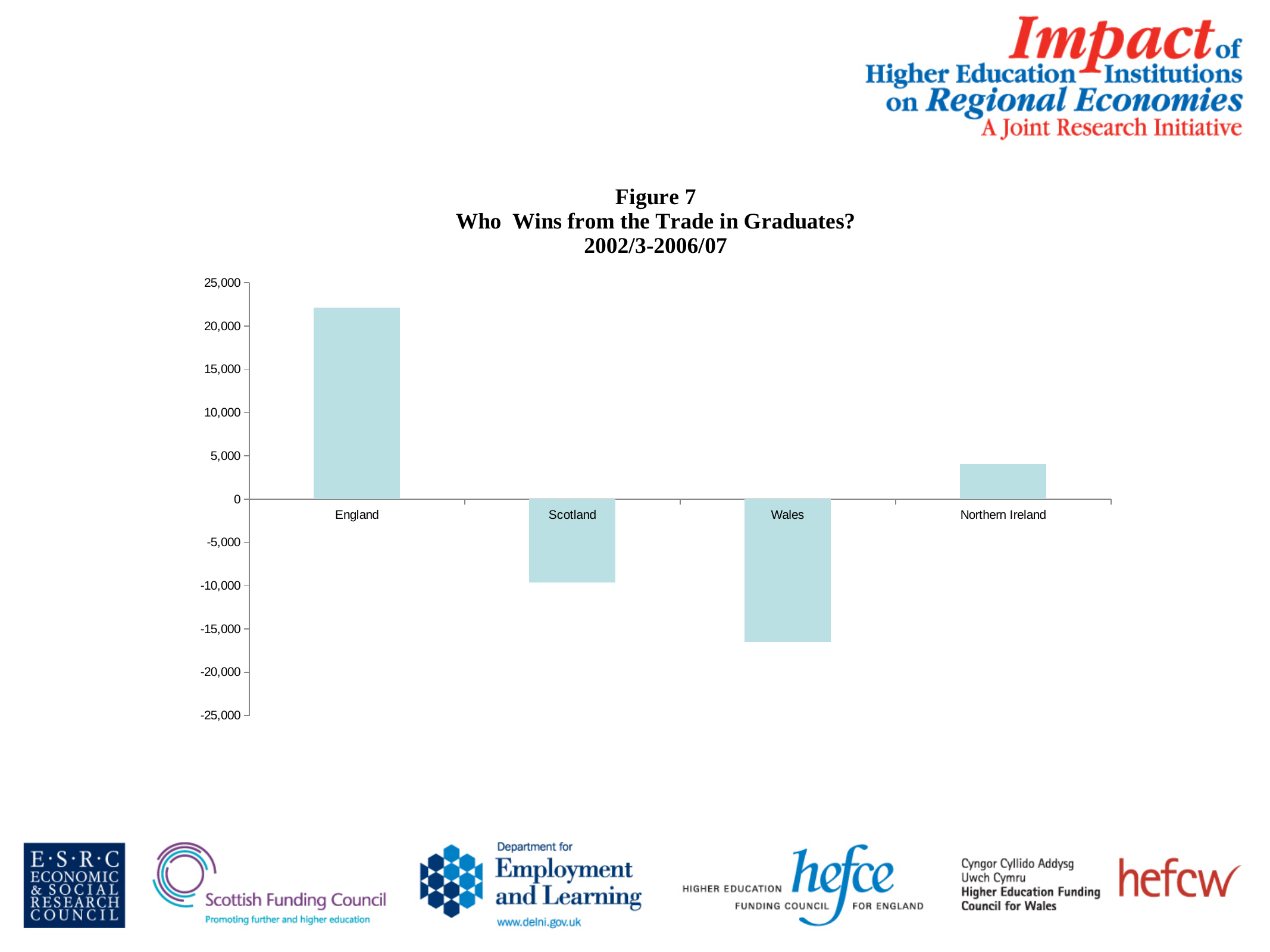
Which is larger, the value for Scotland or the value for Wales? Scotland How many categories have a negative value? 2 Which category has the lowest value? Wales Which is larger, the value for England or the value for Northern Ireland? England Is the value for Northern Ireland greater or less than 5,000? less What period does the chart title say the data covers? 2002/3-2006/07 How many categories are plotted on the chart? 4 Is the value for England greater or less than 20,000? greater Which category has the highest value? England What kind of chart is shown on the slide? bar chart Is the value for Wales greater or less than -15,000? less